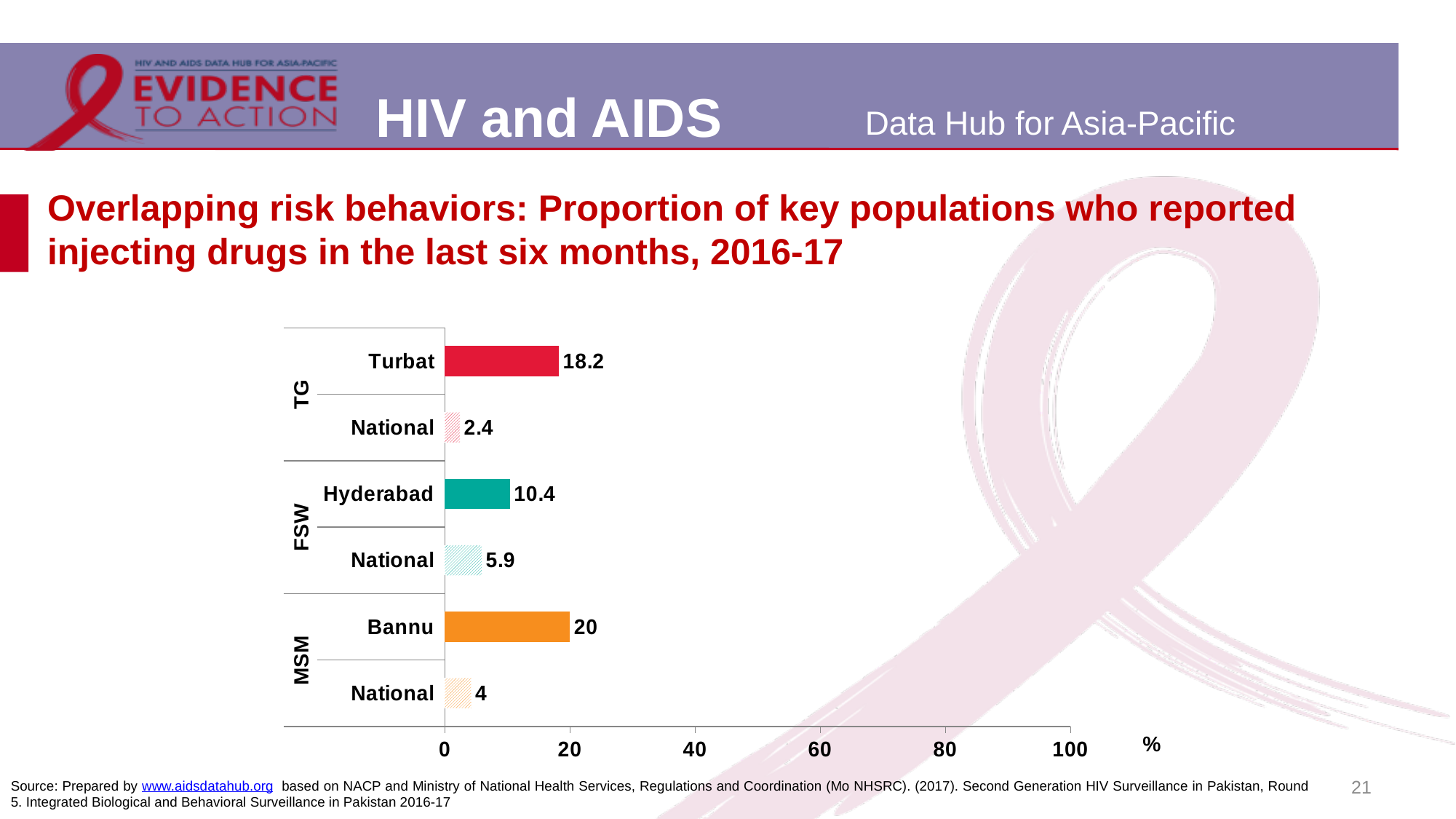
What is the National value for FSW? 5.9 What is the National value for MSM? 4 What is the value for Turbat in the TG group? 18.2 Which bar has the lowest value on the chart? National (TG) How many bars are plotted on the chart? 6 What is the value for Bannu in the MSM group? 20 Which is larger, the value for Hyderabad or the value for Turbat? Turbat What is the maximum value shown on the horizontal axis? 100 What is the difference between the Turbat value and the TG National value? 15.8 What kind of chart is shown on the slide? Bar chart What is the difference between the Hyderabad value and the FSW National value? 4.5 Which bar has the highest value on the chart? Bannu (MSM)